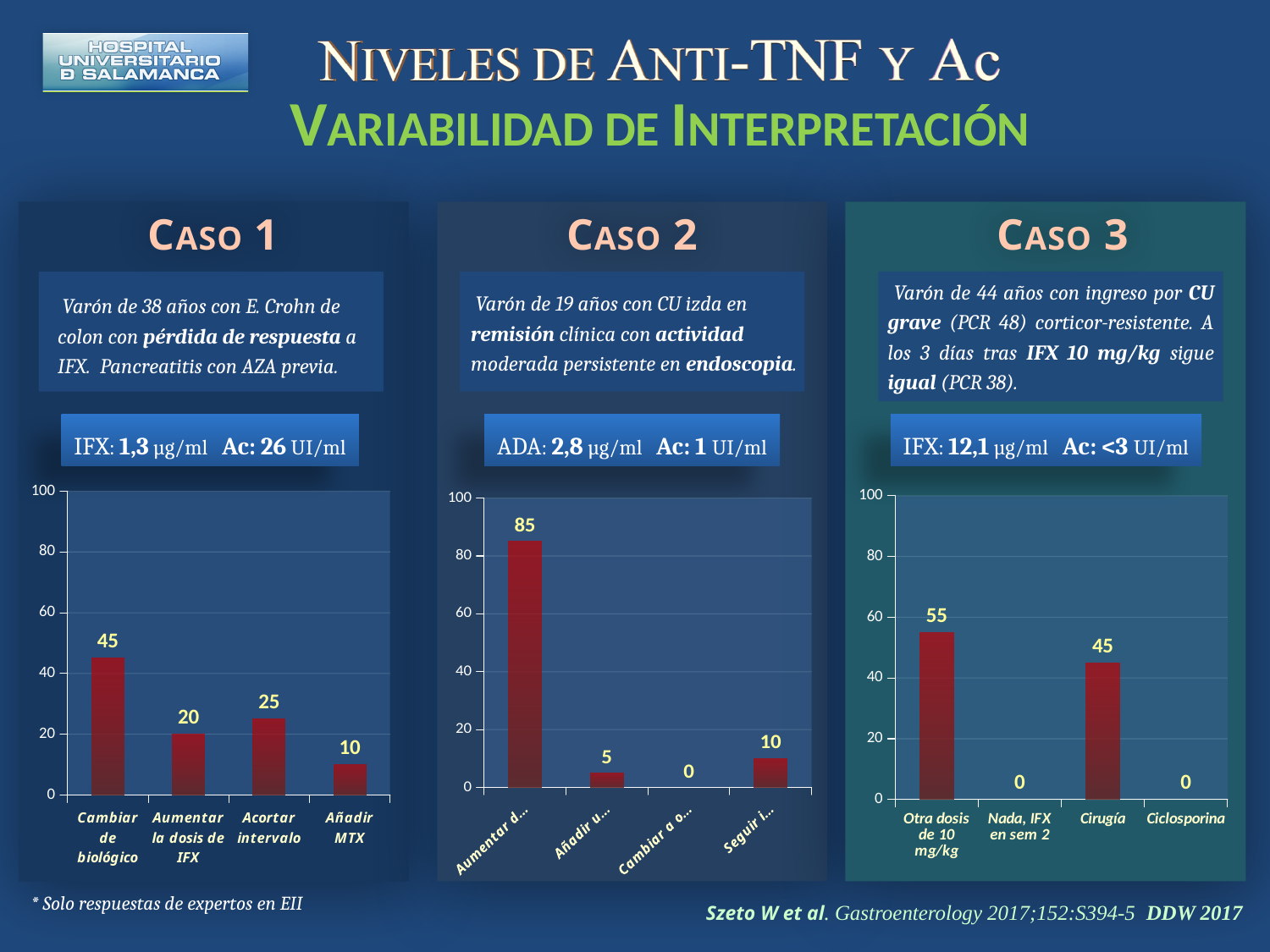
In the Caso 1 chart, which is larger: 'Aumentar la dosis de IFX' or 'Acortar intervalo'? Acortar intervalo In the Caso 2 chart, what is the value of the first (leftmost) bar? 85 In the Caso 1 chart, which category has the lowest value? Añadir MTX In the Caso 1 chart, what is the difference between 'Cambiar de biológico' and 'Acortar intervalo'? 20 In the Caso 3 chart, what is the value for 'Cirugía'? 45 In the Caso 2 chart, what is the value of the last (rightmost) bar? 10 In the Caso 2 chart, what is the difference between the first bar and the second bar? 80 How many categories are shown in the Caso 1 chart? 4 In the Caso 3 chart, what is the value for 'Ciclosporina'? 0 In the Caso 3 chart, which category has the highest value? Otra dosis de 10 mg/kg In the Caso 1 chart, what is the value for 'Cambiar de biológico'? 45 What type of chart is used in the Caso 3 panel? Bar chart